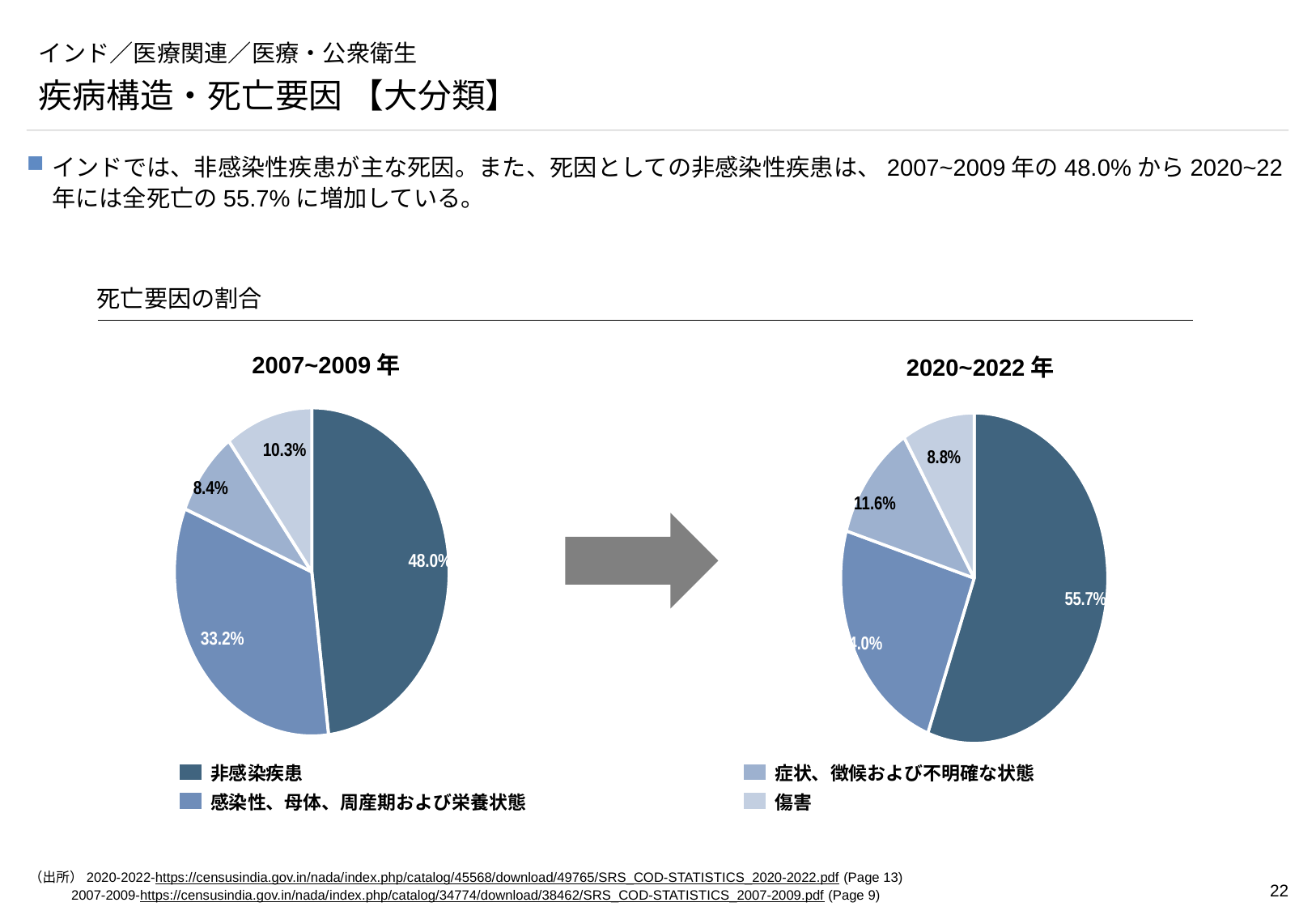
In the 2007~2009 年 pie chart, which is larger: the share for 傷害 or the share for 症状、徴候および不明確な状態? 傷害 In the 2007~2009 年 pie chart, what share is shown for 感染性、母体、周産期および栄養状態? 33.2% How many categories does the legend list for the pie charts? 4 In the 2020~2022 年 pie chart, what share is shown for 症状、徴候および不明確な状態? 11.6% In the 2020~2022 年 pie chart, what share is shown for 非感染疾患? 55.7% In the 2007~2009 年 pie chart, which category has the smallest share? 症状、徴候および不明確な状態 In the 2020~2022 年 pie chart, what share is shown for 傷害? 8.8% What type of chart is used to show 死亡要因の割合 on this slide? Pie chart In the 2007~2009 年 pie chart, which category has the largest share? 非感染疾患 In the 2007~2009 年 pie chart, what share is shown for 非感染疾患? 48.0% By how many percentage points did the share of 非感染疾患 change from the 2007~2009 年 chart to the 2020~2022 年 chart? 7.7 percentage points In the 2007~2009 年 pie chart, what share is shown for 傷害? 10.3%